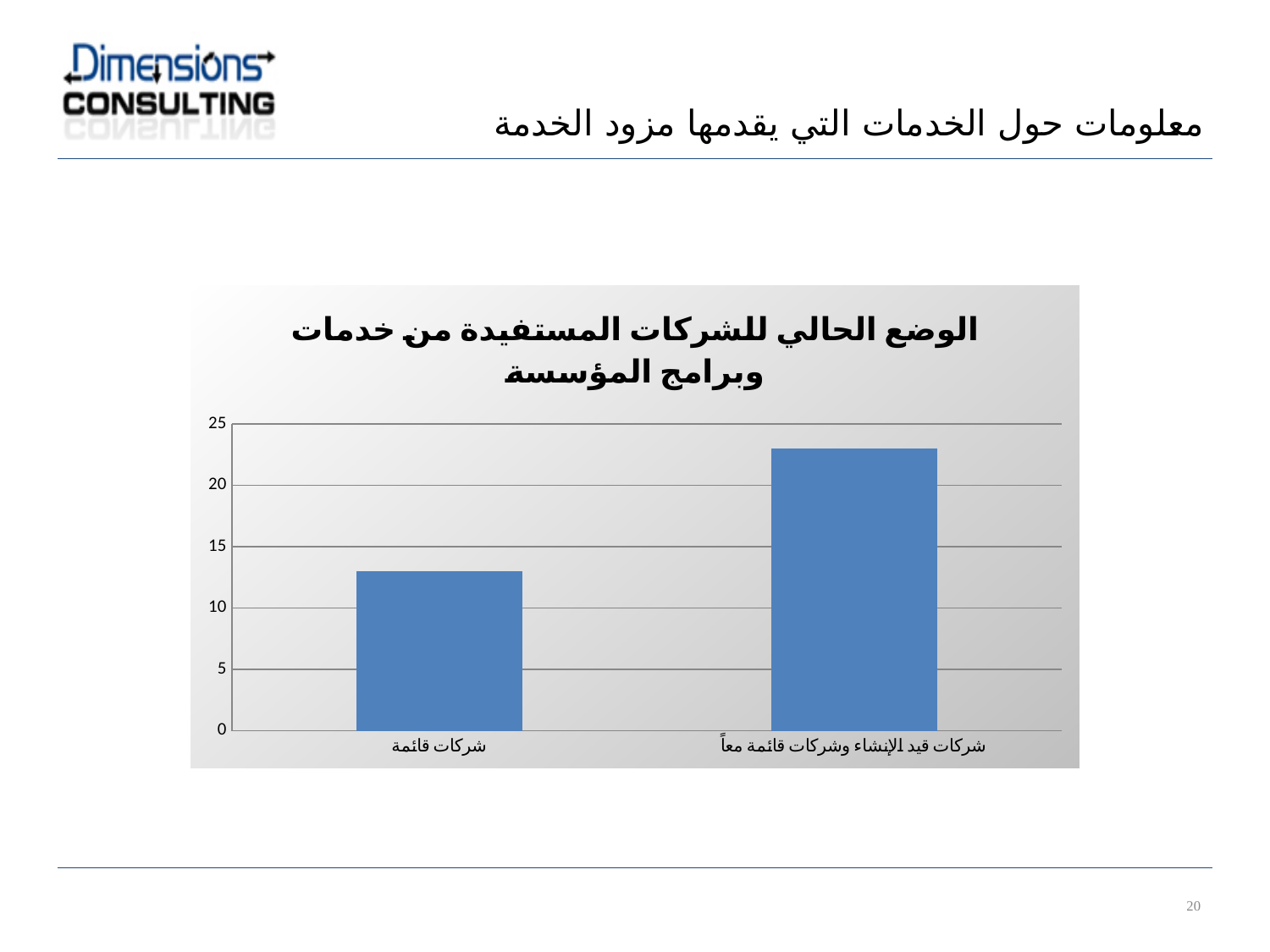
Is the value for شركات قائمة greater or less than 10? greater What kind of chart is shown on the slide? bar chart What is the highest value shown on the vertical axis of the chart? 25 What is the title of the chart? الوضع الحالي للشركات المستفيدة من خدمات وبرامج المؤسسة Is the value for شركات قيد الإنشاء وشركات قائمة معاً greater or less than 20? greater Which category has the highest bar in the chart? شركات قيد الإنشاء وشركات قائمة معاً Is the value for شركات قيد الإنشاء وشركات قائمة معاً greater or less than 25? less Which category has the lowest bar in the chart? شركات قائمة Which is larger, the value for شركات قائمة or the value for شركات قيد الإنشاء وشركات قائمة معاً? شركات قيد الإنشاء وشركات قائمة معاً Do the bar values rise or fall from left to right along the x axis? rise How many categories are plotted in the chart? 2